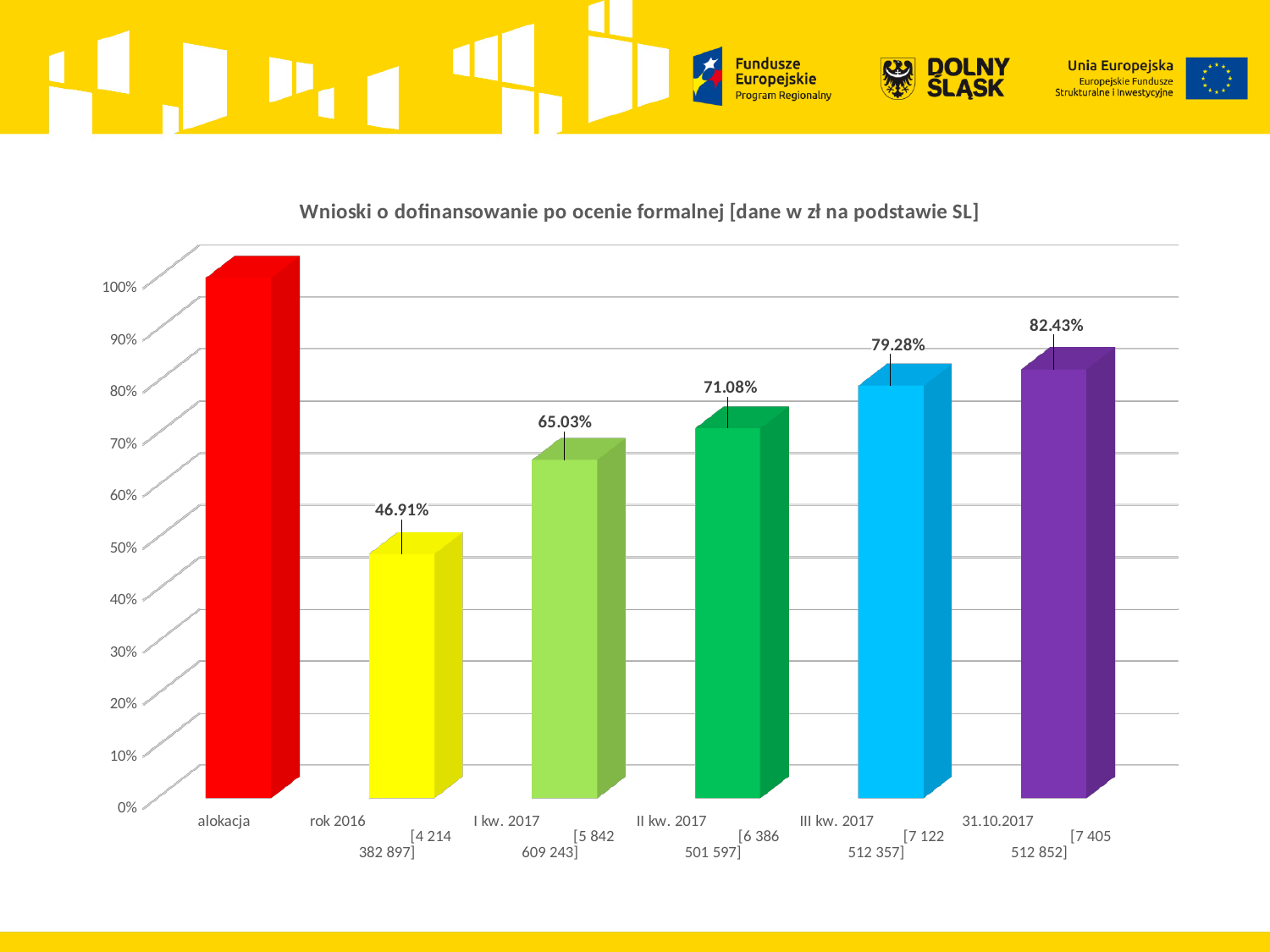
Which category has the highest value? alokacja What is the difference between the values for 31.10.2017 and III kw. 2017? 3.15% What is the value for rok 2016? 46.91% What is the value for II kw. 2017? 71.08% Is the value for alokacja greater or less than 90%? greater Which is larger, the value for I kw. 2017 or the value for II kw. 2017? II kw. 2017 What is the value for III kw. 2017? 79.28% What is the value for I kw. 2017? 65.03% How many bars are shown in the chart? 6 Which category has the lowest value? rok 2016 What kind of chart is shown on the slide? bar chart What is the value for 31.10.2017? 82.43%